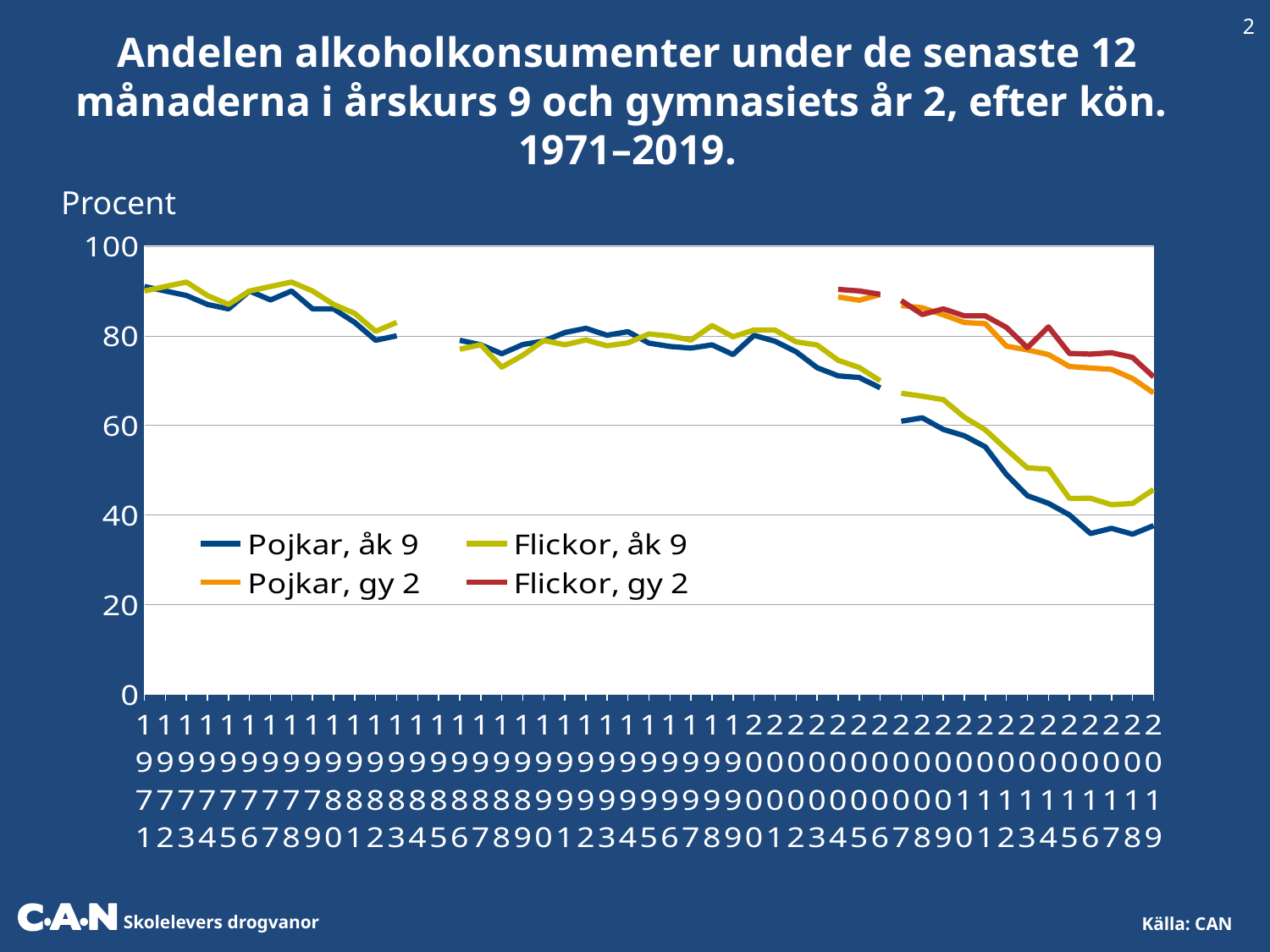
What kind of chart is shown on the slide? Line chart Is the value for Pojkar, åk 9 in 1971 greater or less than 80? greater Which series has the highest value in 2019? Flickor, gy 2 Which series are listed in the legend? Pojkar, åk 9; Flickor, åk 9; Pojkar, gy 2; Flickor, gy 2 What is the unit shown on the y axis? Procent In 2019, which is larger: Flickor, åk 9 or Pojkar, åk 9? Flickor, åk 9 Is the value for Pojkar, åk 9 in 2019 greater or less than 40? less Which series has the lowest value in 2019? Pojkar, åk 9 Is the value for Flickor, åk 9 in 2019 greater or less than 40? greater Does the Pojkar, åk 9 series rise or fall overall from 1971 to 2019? fall How many series does the legend list? 4